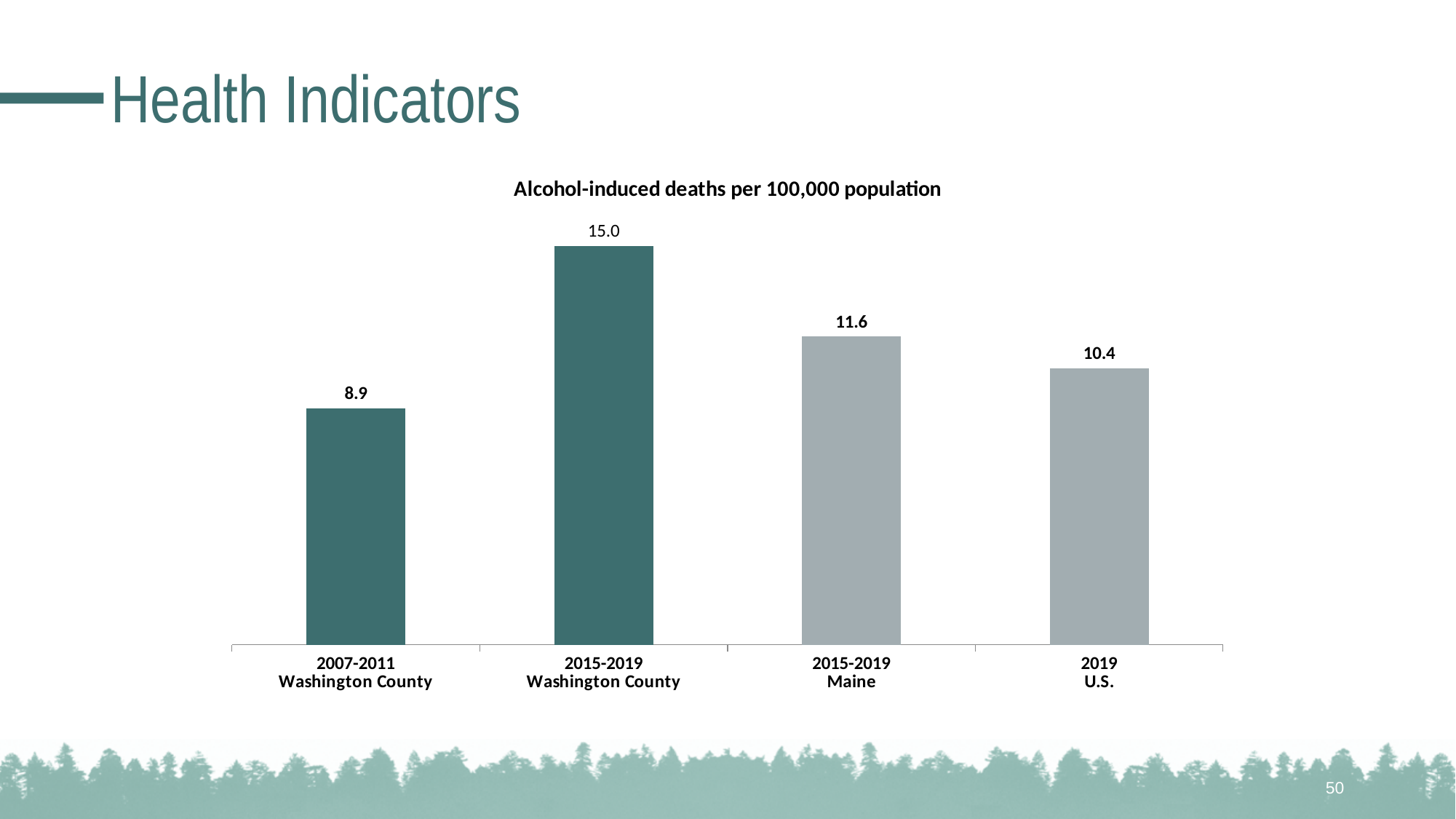
Which category has the highest value? 2015-2019 Washington County What is the difference between the 2015-2019 Washington County value and the 2007-2011 Washington County value? 6.1 Which category has the lowest value? 2007-2011 Washington County What is the difference between the 2015-2019 Maine value and the 2019 U.S. value? 1.2 What is the value for 2019 U.S.? 10.4 What is the value for 2015-2019 Maine? 11.6 Which is larger, the value for 2015-2019 Maine or the value for 2019 U.S.? 2015-2019 Maine What kind of chart is shown on the slide? bar chart What is the title of the chart? Alcohol-induced deaths per 100,000 population What is the value for 2015-2019 Washington County? 15.0 What is the value for 2007-2011 Washington County? 8.9 How many categories are shown in the chart? 4